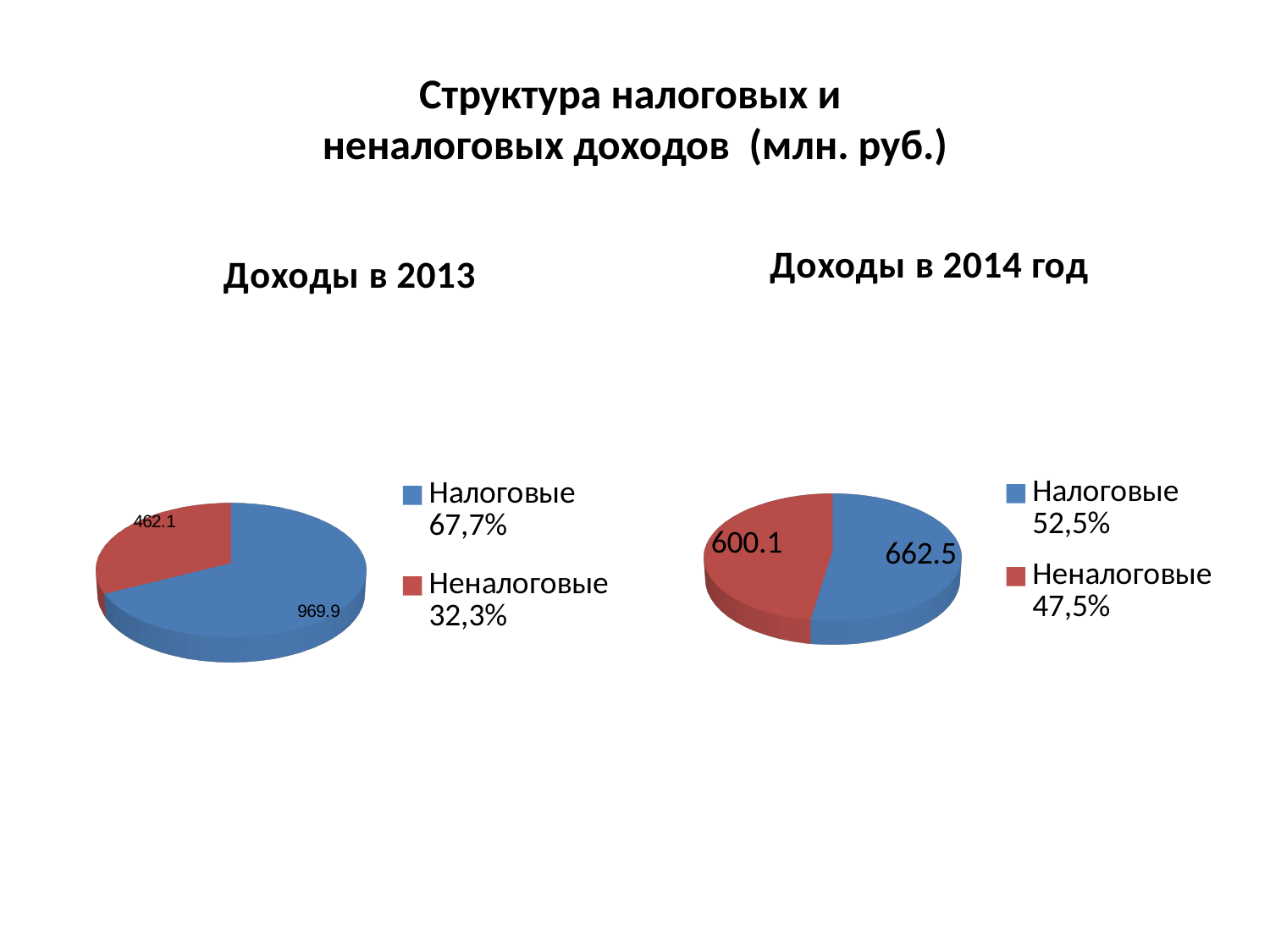
In the "Доходы в 2013" chart, which category is the largest? Налоговые In the "Доходы в 2014 год" chart, what is the value for Неналоговые? 600.1 What type of chart is used for "Доходы в 2013"? Pie chart How many entries does the legend of the "Доходы в 2014 год" chart list? 2 In the "Доходы в 2014 год" chart, what share of the pie is Налоговые? 52,5% In the "Доходы в 2014 год" chart, what is the total of Налоговые and Неналоговые? 1262.6 In the "Доходы в 2013" chart, what is the value for Неналоговые? 462.1 In the "Доходы в 2014 год" chart, what is the value for Налоговые? 662.5 In the "Доходы в 2013" chart, what is the difference between Налоговые and Неналоговые? 507.8 In the "Доходы в 2013" chart, what share of the pie is Неналоговые? 32,3% In the "Доходы в 2014 год" chart, which category is the smallest? Неналоговые In the "Доходы в 2013" chart, what is the value for Налоговые? 969.9